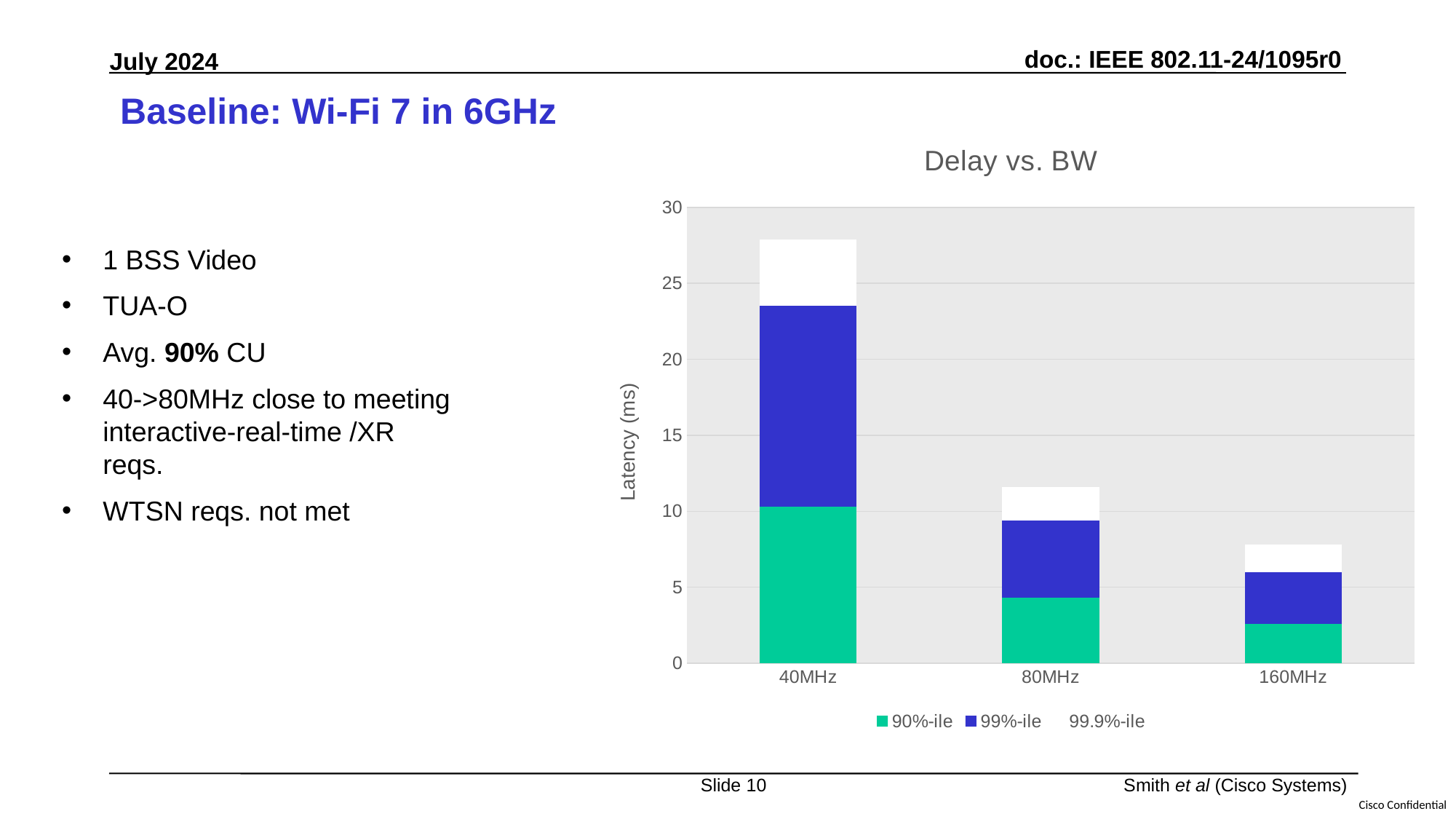
Is the total stacked latency for 40MHz greater or less than 25? greater How many series does the chart's legend list? 3 What type of chart is shown on the slide? bar chart Which bandwidth category has the highest total latency in the chart? 40MHz What is the title of the chart? Delay vs. BW Is the total stacked latency for 160MHz greater or less than 10? less Is the 90%-ile latency for 160MHz greater or less than 5? less What is the label of the y axis of the chart? Latency (ms) How many bandwidth categories are shown on the x axis of the chart? 3 Do the latency values rise or fall as bandwidth increases along the x axis? fall Which bandwidth category has the lowest total latency in the chart? 160MHz